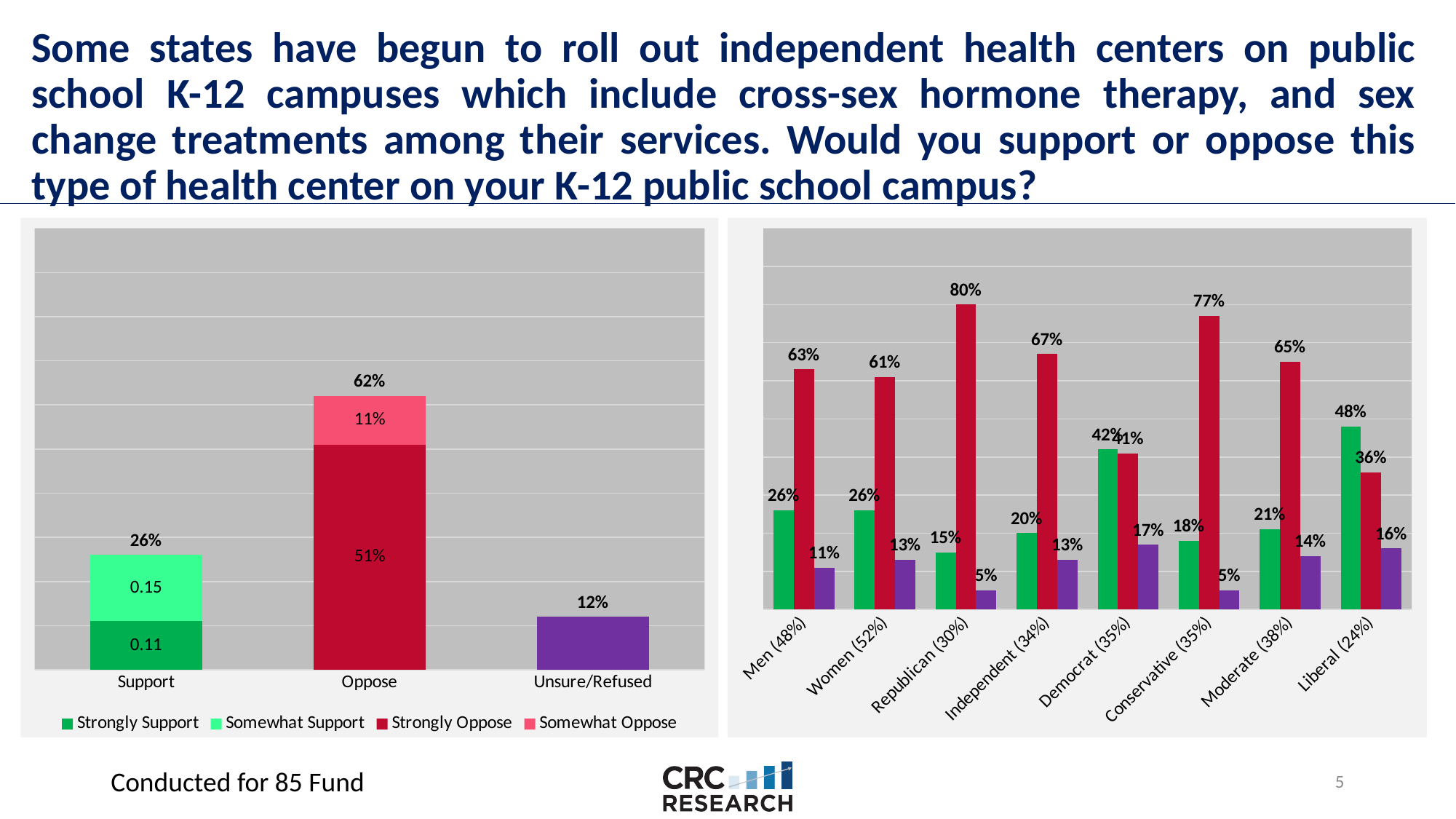
In the right chart, how many categories are shown on the x axis? 8 In the left chart, what is the value for Unsure/Refused? 12% In the right chart, which category has the highest green bar? Liberal (24%) In the right chart, is the red bar for Conservative (35%) larger or smaller than the red bar for Moderate (38%)? larger In the right chart, what is the value of the purple bar for Democrat (35%)? 17% In the left chart, what value is printed on the Strongly Oppose segment of the Oppose bar? 51% In the left chart, what is the total value shown for the Oppose bar? 62% In the left chart, how many series does the legend list? 4 In the left chart, what is the difference between the Oppose total and the Support total? 36% In the right chart, which category has the lowest red bar? Liberal (24%) In the right chart, what is the value of the red bar for Republican (30%)? 80% What kind of chart is the chart on the right? bar chart